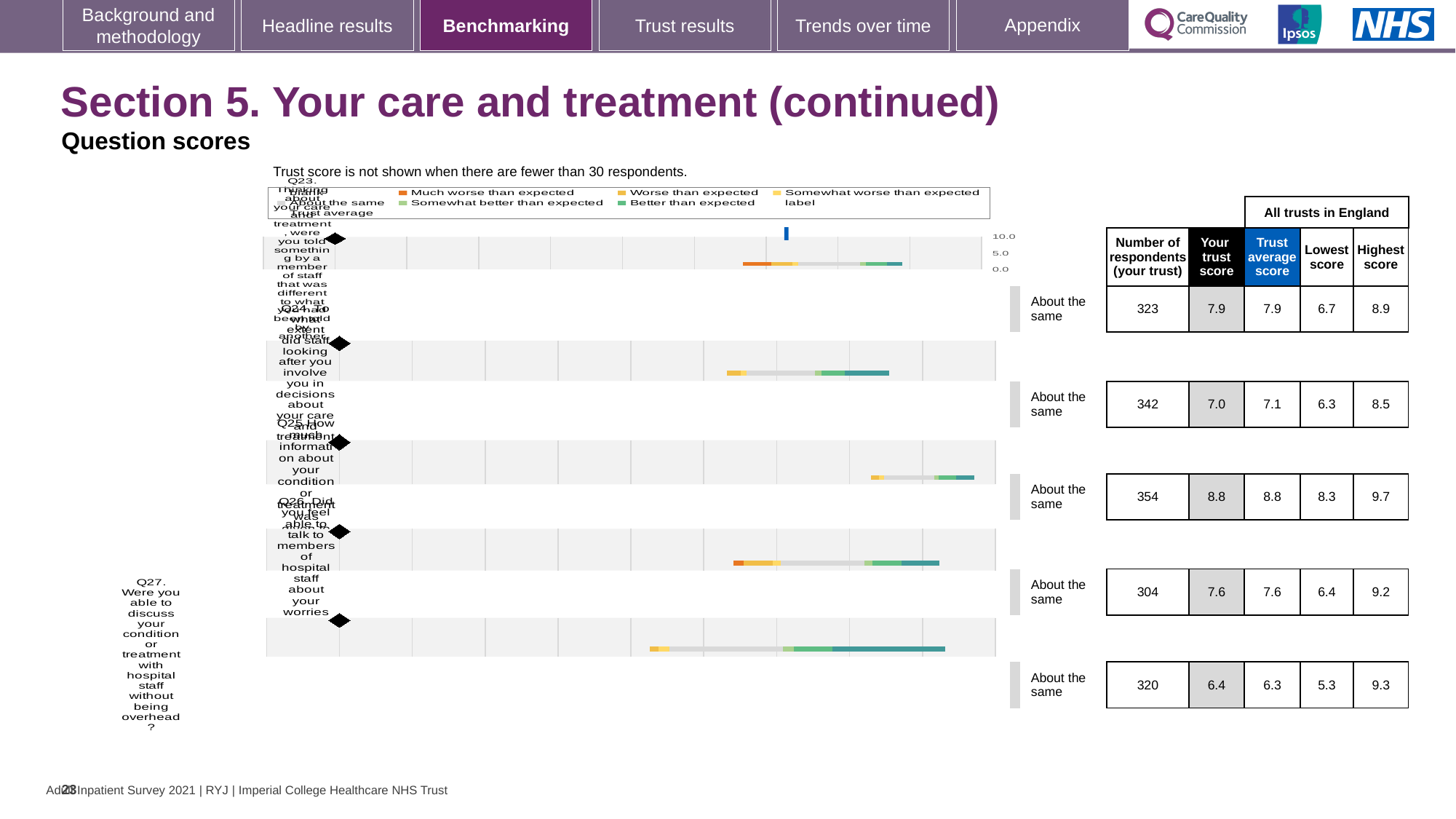
What kind of chart is used to show the question scores on this slide? bar chart How many questions (Q23 to Q27) are plotted in the chart? 5 For Q26, what is the difference between the highest score and the lowest score across all trusts in England? 2.8 What is your trust score for Q25? 8.8 For Q24, which is larger: your trust score or the trust average score? Trust average score Which question has the highest 'Your trust score'? Q25 What benchmark label is shown next to each question's bar? About the same What is the number of respondents (your trust) for Q23? 323 What is the lowest score across all trusts in England for Q27? 5.3 Which question has the lowest 'Your trust score'? Q27 What is the maximum value shown on the chart's score axis? 10.0 What is the trust average score for Q27? 6.3